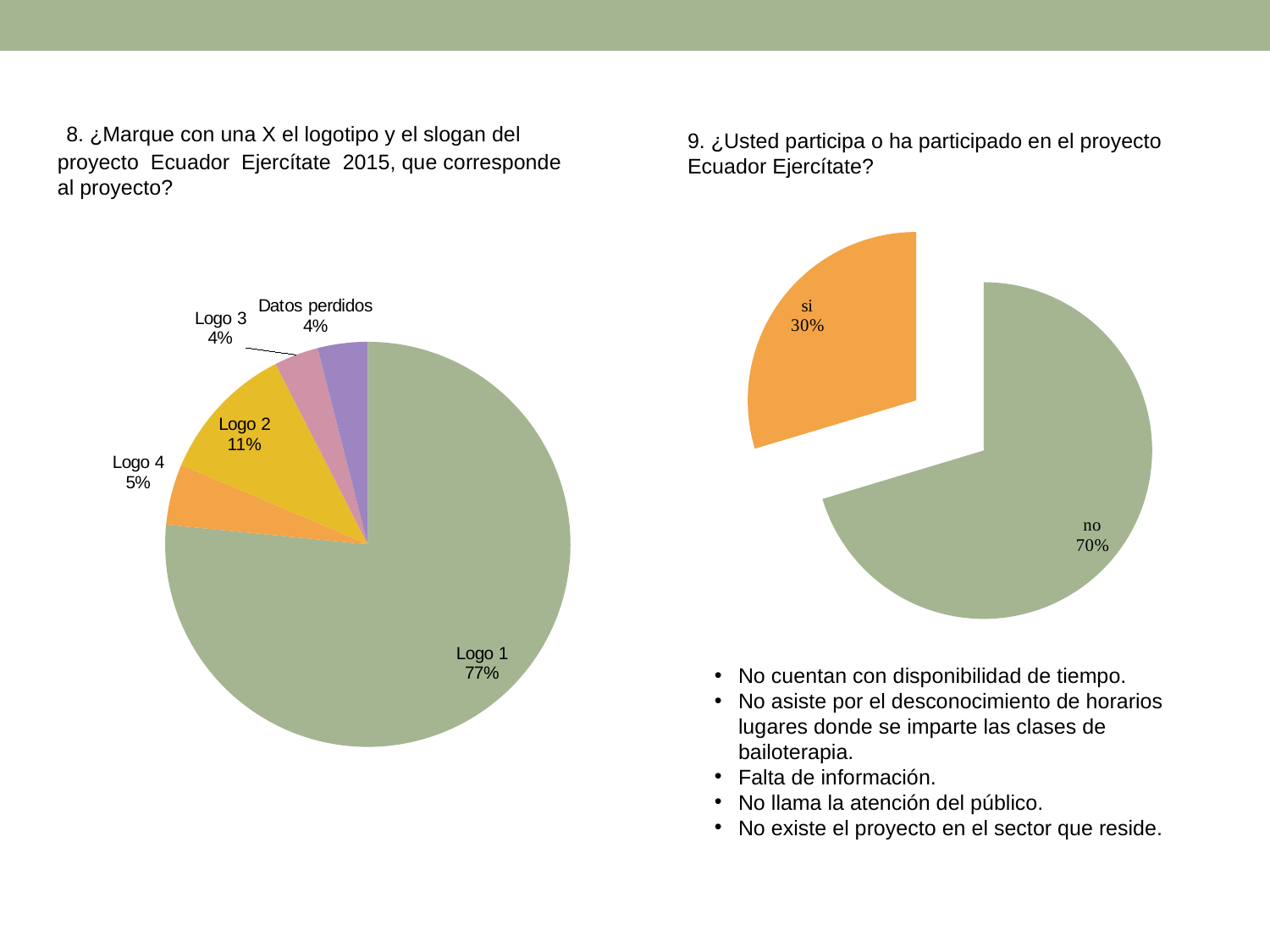
In the right pie chart (question 9), what is the difference between the 'no' and 'si' shares? 40% In the left pie chart (question 8), what share is labelled Datos perdidos? 4% In the left pie chart (question 8), what share does Logo 4 have? 5% In the left pie chart (question 8), what is the difference between the shares of Logo 1 and Logo 2? 66% In the right pie chart (question 9), what share answered 'no'? 70% In the left pie chart (question 8), which category has the largest slice? Logo 1 In the right pie chart (question 9), what share answered 'si'? 30% In the left pie chart (question 8), what share does Logo 2 have? 11% What type of chart is shown on the right side of the slide (question 9)? Pie chart In the left pie chart (question 8), what share does Logo 1 have? 77% In the left pie chart (question 8), which is larger, Logo 2 or Logo 4? Logo 2 In the left pie chart (question 8), how many slices does the pie have? 5